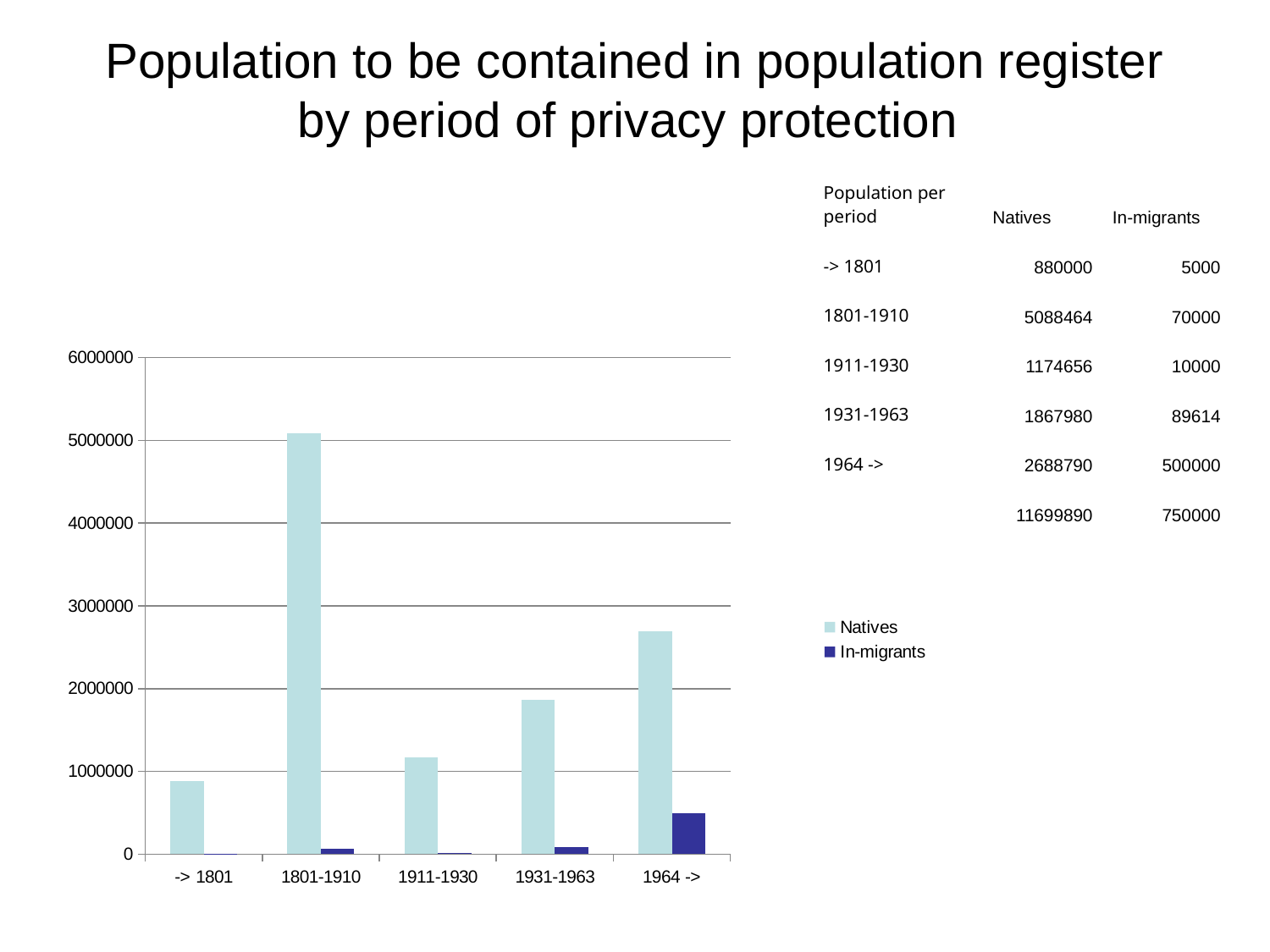
Is the In-migrants value for 1964 -> greater or less than 1000000? less How many periods are shown on the x axis of the chart? 5 Which period has the highest Natives value? 1801-1910 Which period has the highest In-migrants value? 1964 -> Is the Natives value for 1801-1910 greater or less than 5000000? greater How many series does the chart legend list? 2 According to the table on the slide, what is the Natives value for 1931-1963? 1867980 Which is larger, the Natives value for 1911-1930 or the Natives value for 1964 ->? 1964 -> What kind of chart is shown on the slide? bar chart Which period has the lowest Natives value? -> 1801 According to the table on the slide, what is the In-migrants value for 1801-1910? 70000 Is the Natives value for 1931-1963 greater or less than 2000000? less